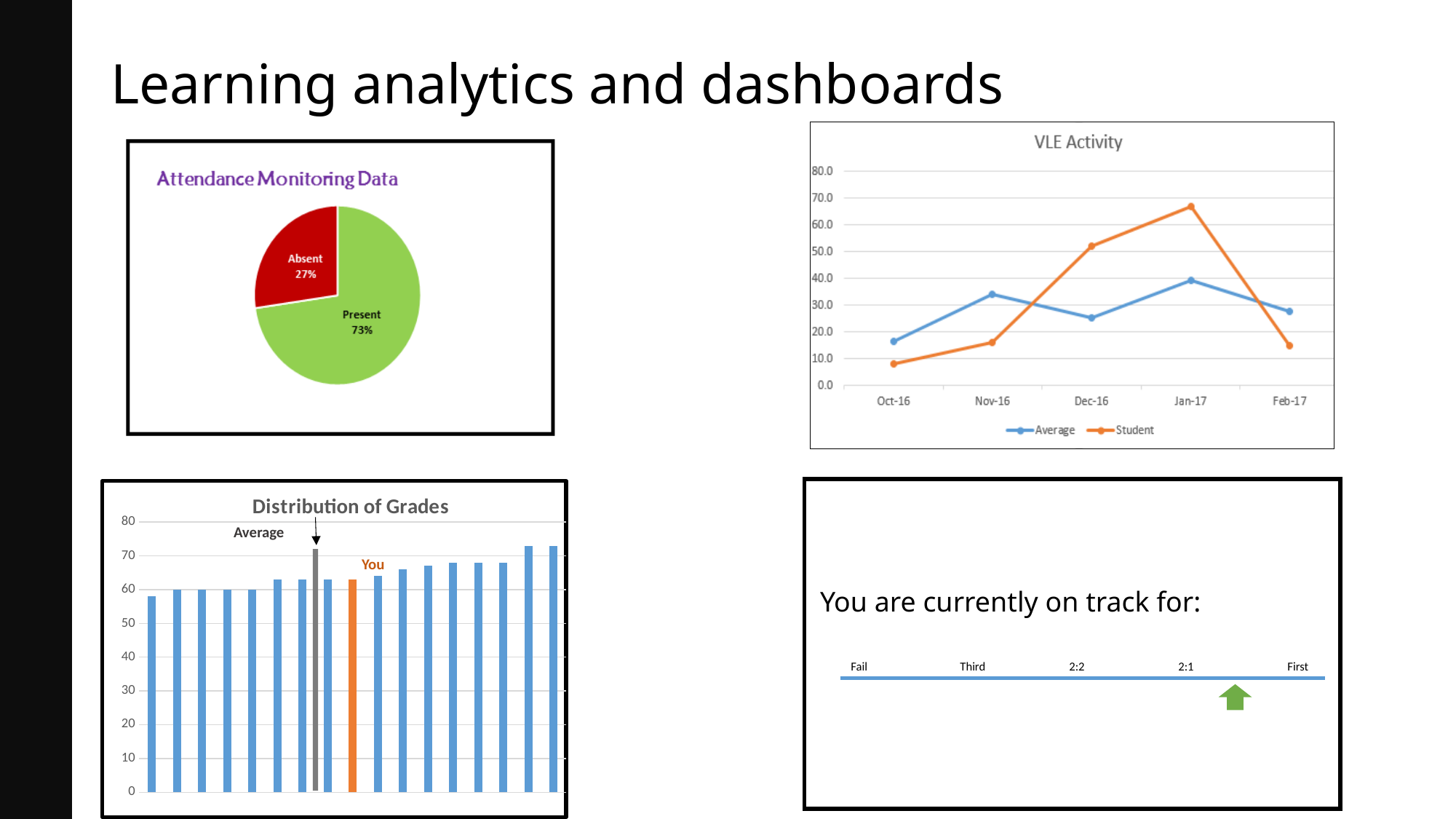
In the VLE Activity chart, which series has the higher value in Dec-16, Average or Student? Student In the Attendance Monitoring Data chart, what share of the pie is Present? 73% How many months are plotted on the x axis of the VLE Activity chart? 5 In the Attendance Monitoring Data chart, which slice is larger, Absent or Present? Present What kind of chart is the Attendance Monitoring Data chart? Pie chart How many series does the legend of the VLE Activity chart list? 2 What kind of chart is the VLE Activity chart? Line chart In the Attendance Monitoring Data chart, what percentage of attendance is marked Absent? 27% In the VLE Activity chart, in which month is the Student series lowest? Oct-16 In the VLE Activity chart, in which month does the Student series reach its highest value? Jan-17 In the VLE Activity chart, is the Student value for Jan-17 greater or less than 60.0? greater In the Distribution of Grades chart, which bar is taller, the Average bar or the You bar? Average